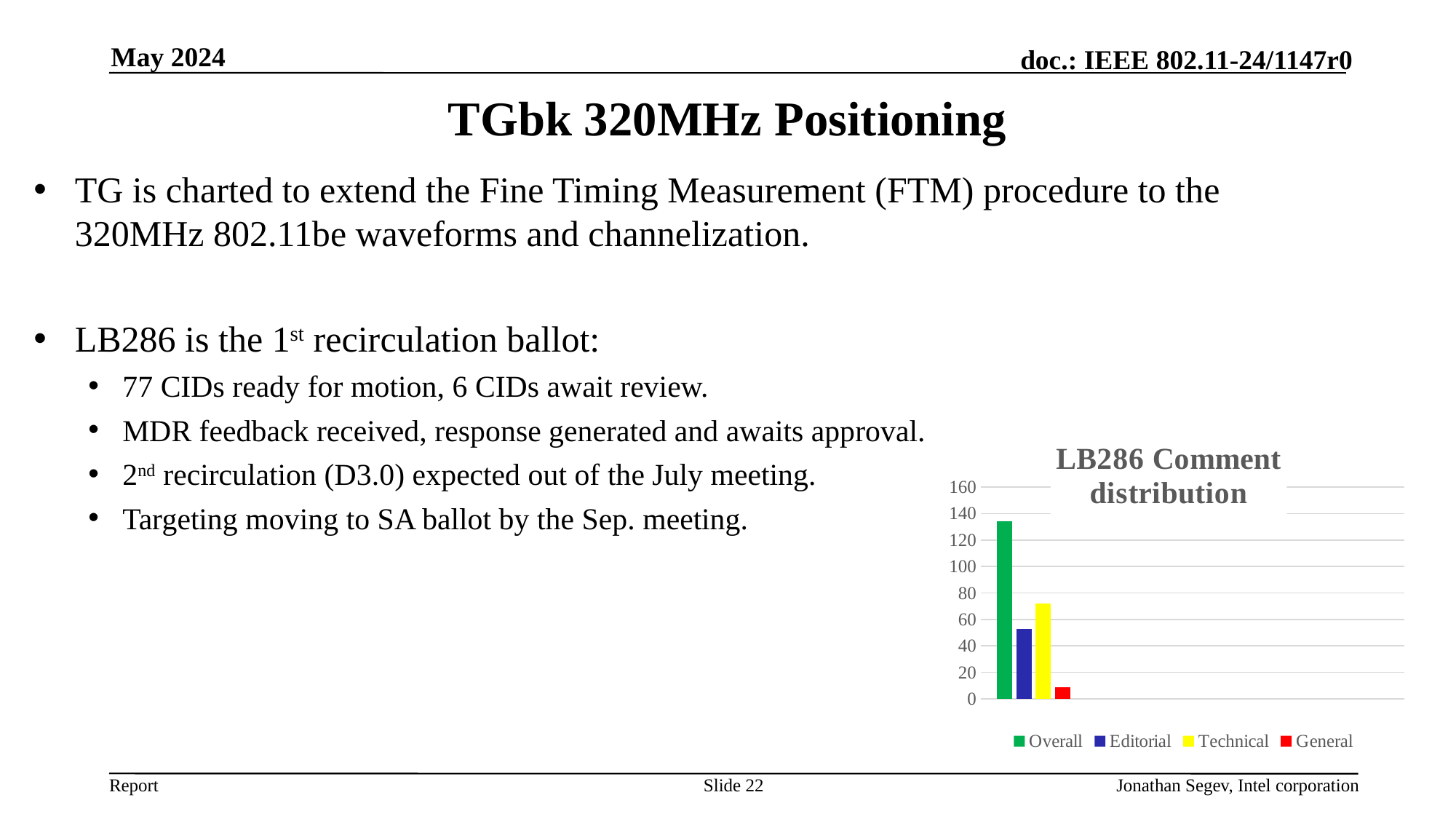
What kind of chart is shown on the slide? bar chart Is the value for Technical greater or less than 60? greater Is the value for Editorial greater or less than 60? less What colour is the bar for the Technical series? yellow Which is larger, the value for General or the value for Editorial? Editorial Which is larger, the value for Editorial or the value for Technical? Technical What is the title of the chart? LB286 Comment distribution Is the value for General greater or less than 20? less How many series does the chart's legend list? 4 Which series has the lowest value in the chart? General Which series has the highest value in the chart? Overall